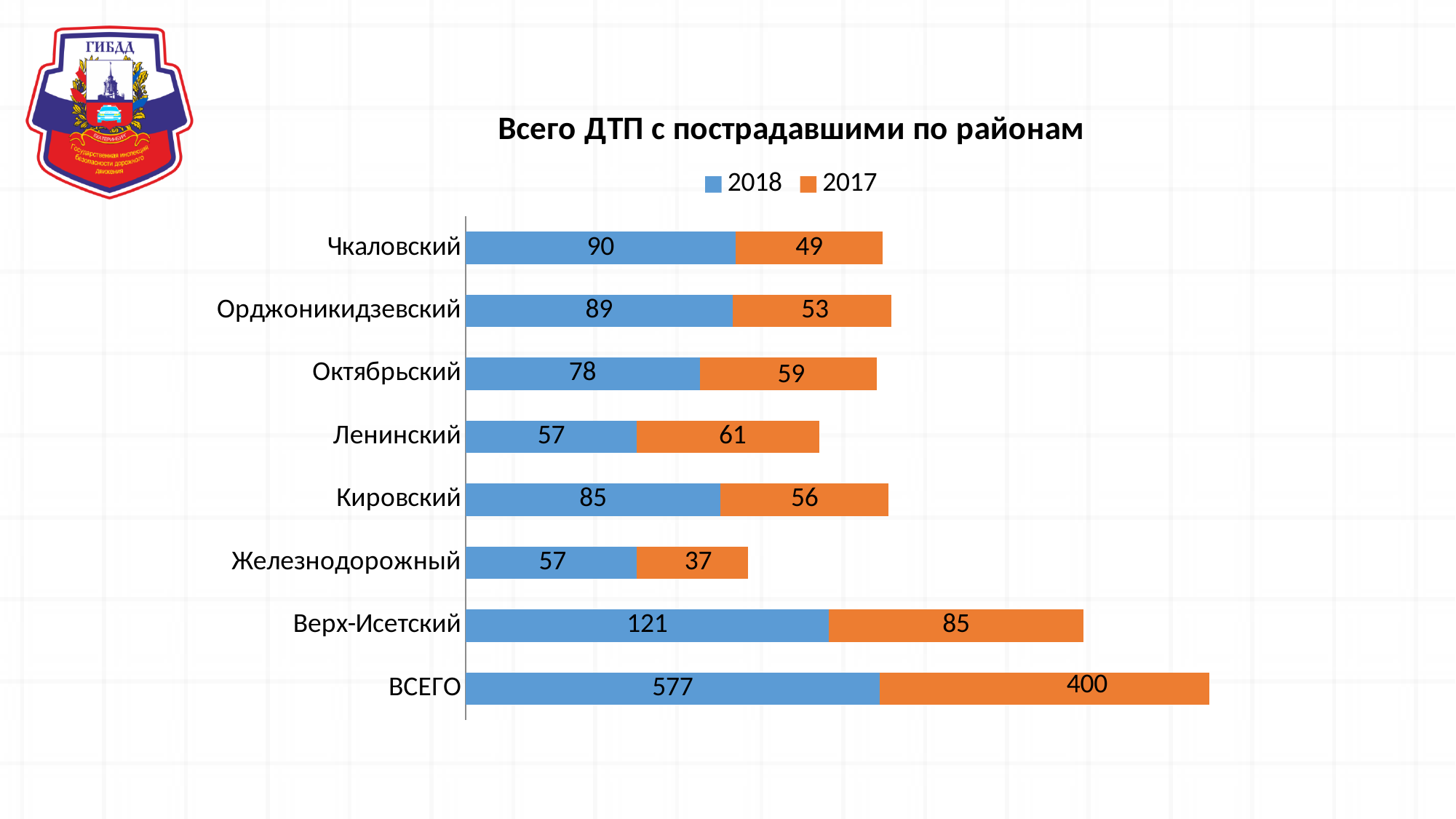
What is the total of the stacked bar for Кировский? 141 What is the 2018 value for ВСЕГО? 577 Among the districts (excluding ВСЕГО), which has the highest 2018 value? Верх-Исетский What is the title of the chart? Всего ДТП с пострадавшими по районам What kind of chart is shown? Stacked bar chart How many series does the legend list? 2 Which is larger for Ленинский: the 2018 value or the 2017 value? 2017 What is the 2018 value for Чкаловский? 90 What is the difference between the 2018 and 2017 values for Верх-Исетский? 36 What is the 2017 value for Ленинский? 61 How many categories are shown on the chart? 8 Among the districts (excluding ВСЕГО), which has the lowest 2017 value? Железнодорожный